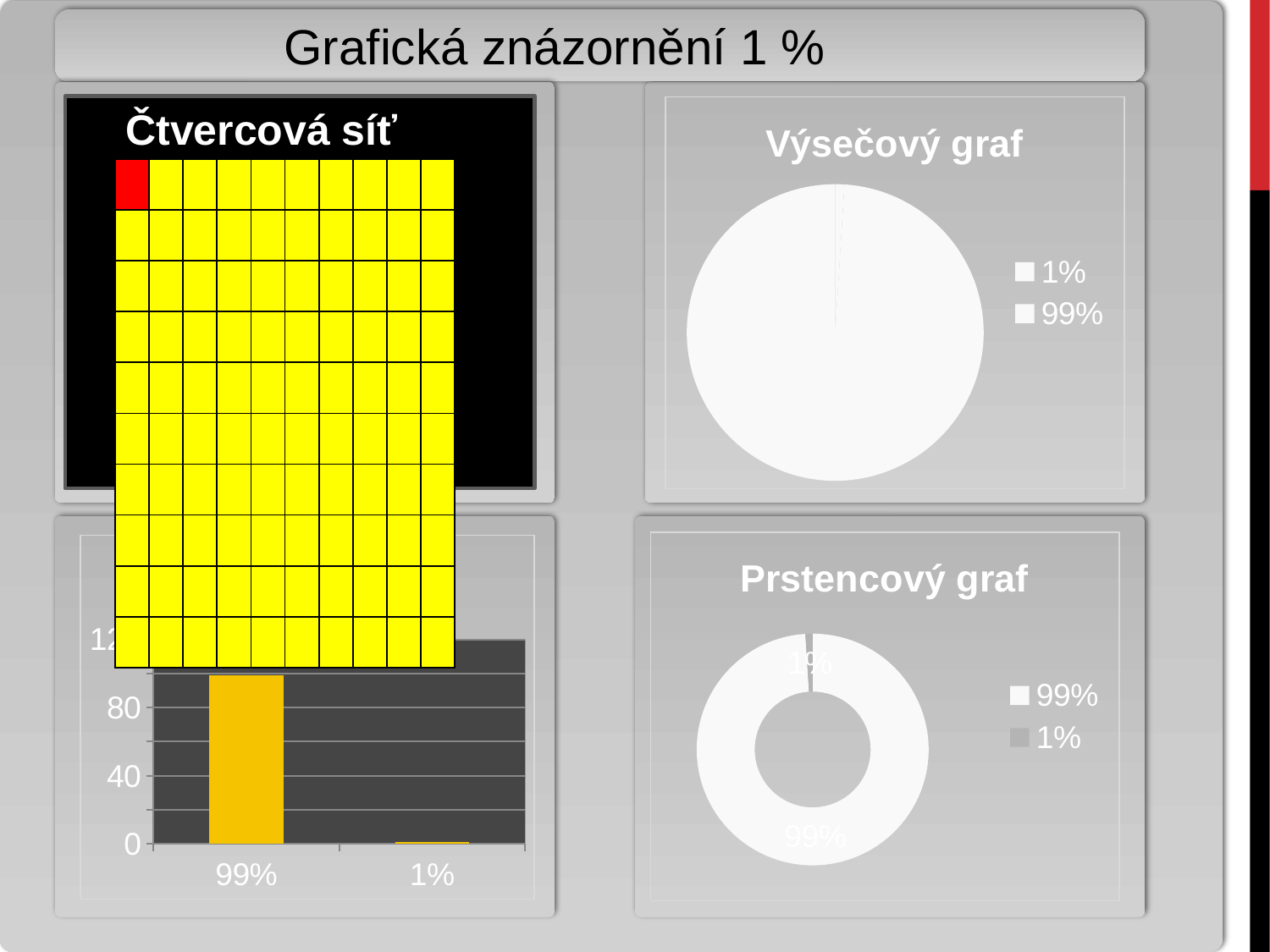
In the chart titled "Výsečový graf", which legend entry corresponds to the larger slice? 99% How many entries does the legend of the chart titled "Výsečový graf" list? 2 In the bottom-left bar chart, is the value for the category "99%" greater or less than 80? greater What kind of chart is the chart in the bottom-left of the slide? bar chart How many categories are shown on the x axis of the bottom-left bar chart? 2 What kind of chart is the chart titled "Prstencový graf"? doughnut chart In the chart titled "Prstencový graf", what data label is shown on the small segment? 1% In the bottom-left bar chart, is the value for the category "1%" greater or less than 40? less In the chart titled "Výsečový graf", what share of the pie does the larger slice represent? 99% What kind of chart is the chart titled "Výsečový graf"? pie chart In the bottom-left bar chart, which category has the tallest bar? 99% In the chart titled "Prstencový graf", what data label is shown on the large segment? 99%